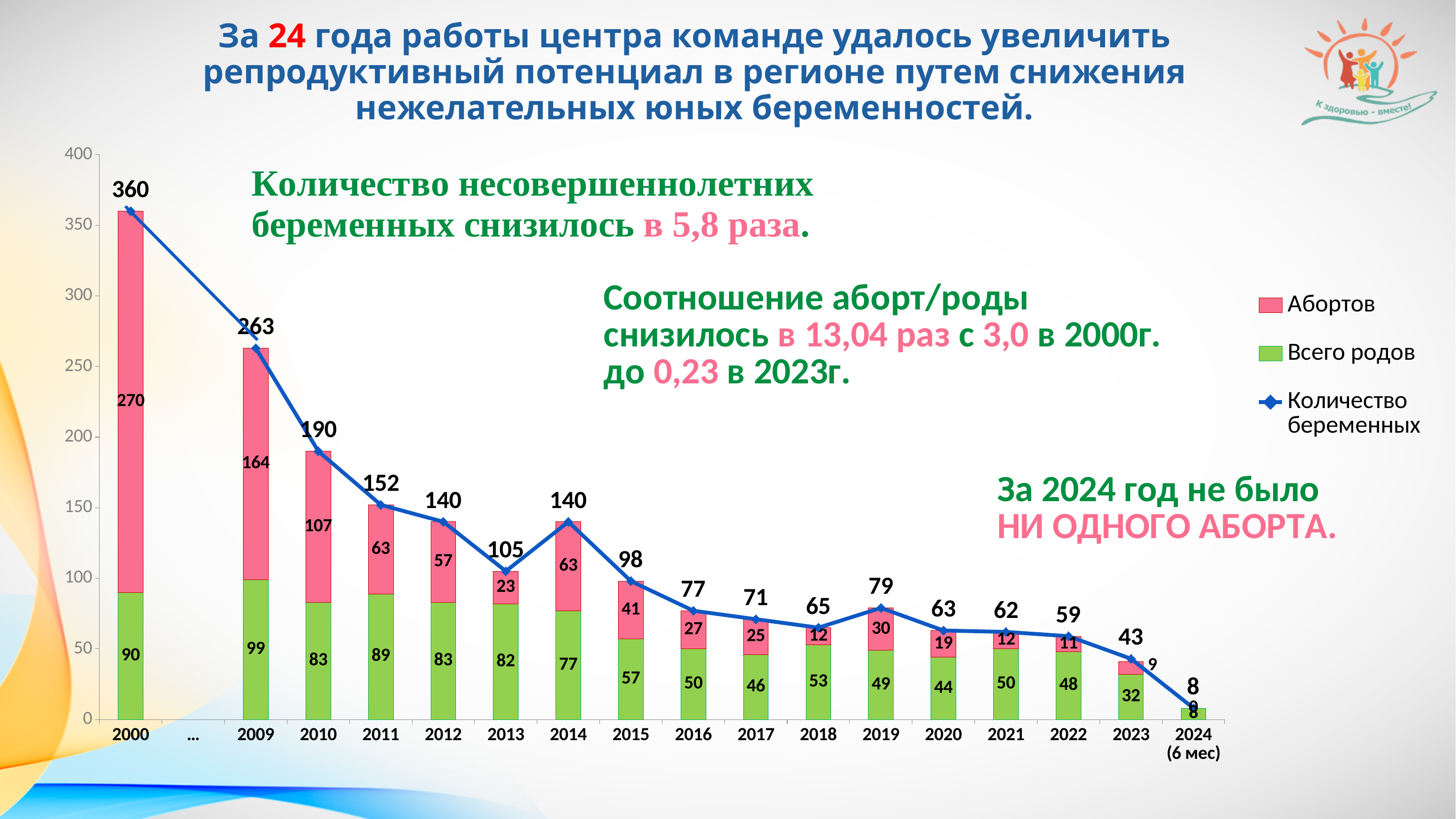
What is the difference between the Абортов values for 2009 and 2010? 57 What colour represents Всего родов in the legend? Green What kind of chart is shown on the slide? Stacked bar chart with a line What is the value for Всего родов in 2014? 77 What is the Количество беременных value for 2019? 79 How many series does the legend list? 3 What is the value for Абортов in 2000? 270 Which category has the lowest Количество беременных value? 2024 (6 мес) What is the value for Абортов in 2018? 12 Which year has the highest Количество беременных value? 2000 Which is larger, the Всего родов value for 2011 or for 2012? 2011 Do the Количество беременных values generally rise or fall from 2000 to 2024? Fall